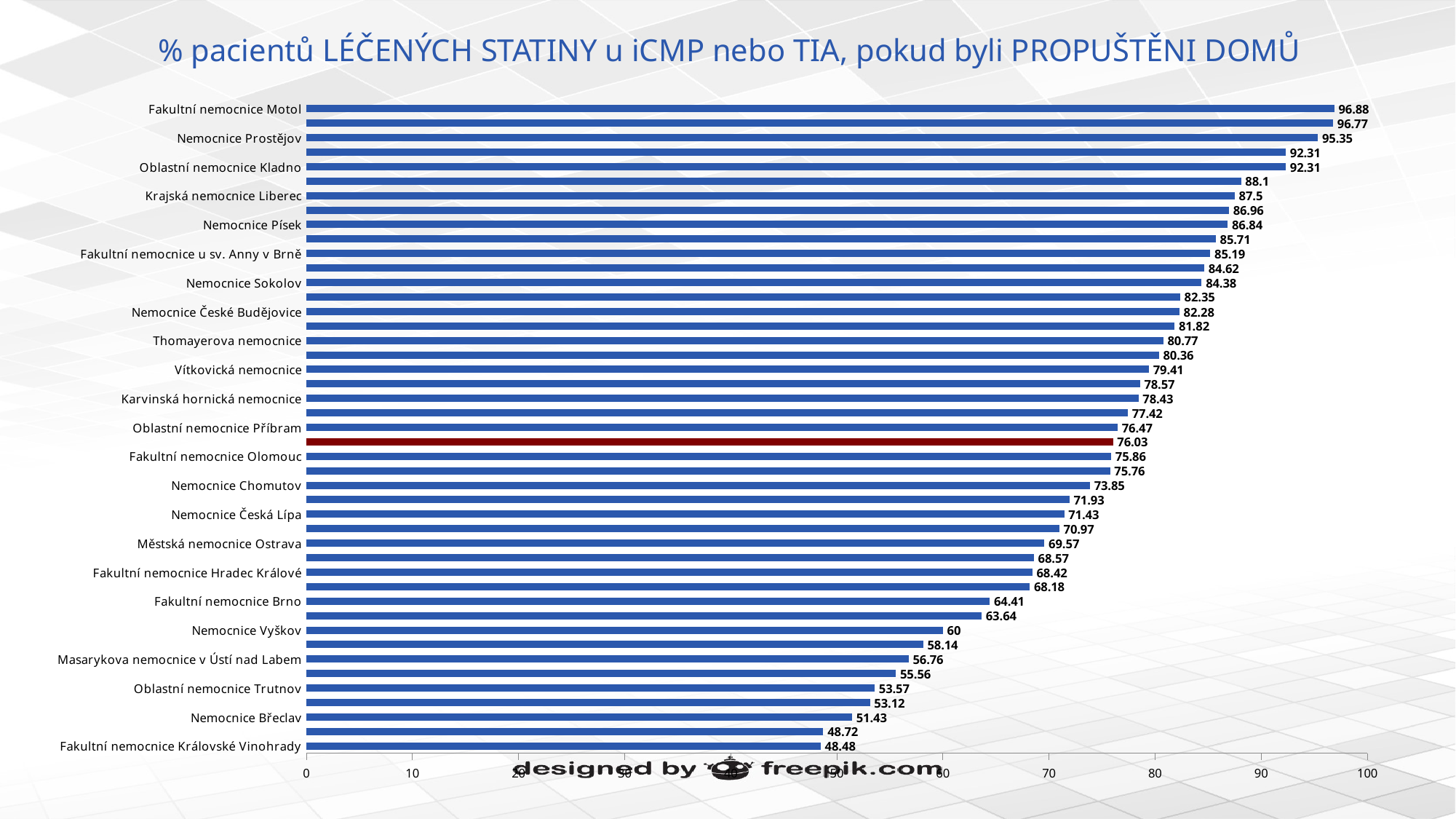
What is the value for Fakultní nemocnice Motol? 96.88 What is the difference between the values for Nemocnice Prostějov and Oblastní nemocnice Kladno? 3.04 What is the value for Oblastní nemocnice Trutnov? 53.57 What is the value for Fakultní nemocnice Olomouc? 75.86 What is the difference between the values for Fakultní nemocnice Motol and Fakultní nemocnice Královské Vinohrady? 48.4 Is the value for Fakultní nemocnice Brno greater or less than 70? less What is the value for Nemocnice Vyškov? 60 Which is larger, the value for Nemocnice Sokolov or the value for Nemocnice Chomutov? Nemocnice Sokolov What value is shown on the bar highlighted in dark red? 76.03 Which labelled hospital has the highest value? Fakultní nemocnice Motol What type of chart is shown on the slide? bar chart Which labelled hospital has the lowest value? Fakultní nemocnice Královské Vinohrady